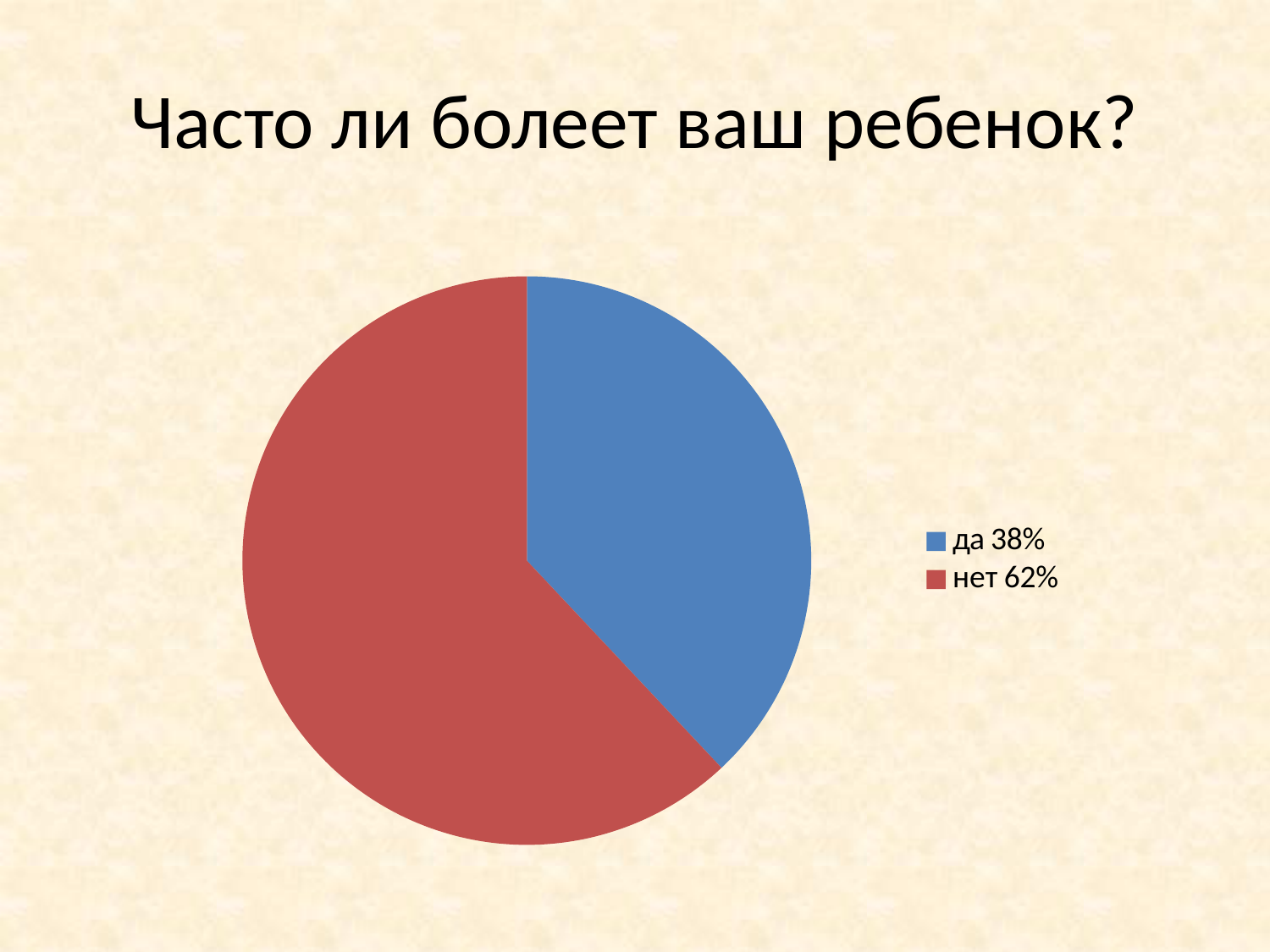
How many slices does the pie chart have? 2 What share of the pie does "да" represent? 38% Which category has the smallest slice of the pie? да Which is larger, the share for "да" or the share for "нет"? нет What kind of chart is shown on the slide? pie chart Which category has the largest slice of the pie? нет What share of the pie does "нет" represent? 62% What is the difference in percentage points between "нет" and "да"? 24 How many entries does the legend list? 2 What is the title of the chart? Часто ли болеет ваш ребенок? What colour is the slice for "нет"? red